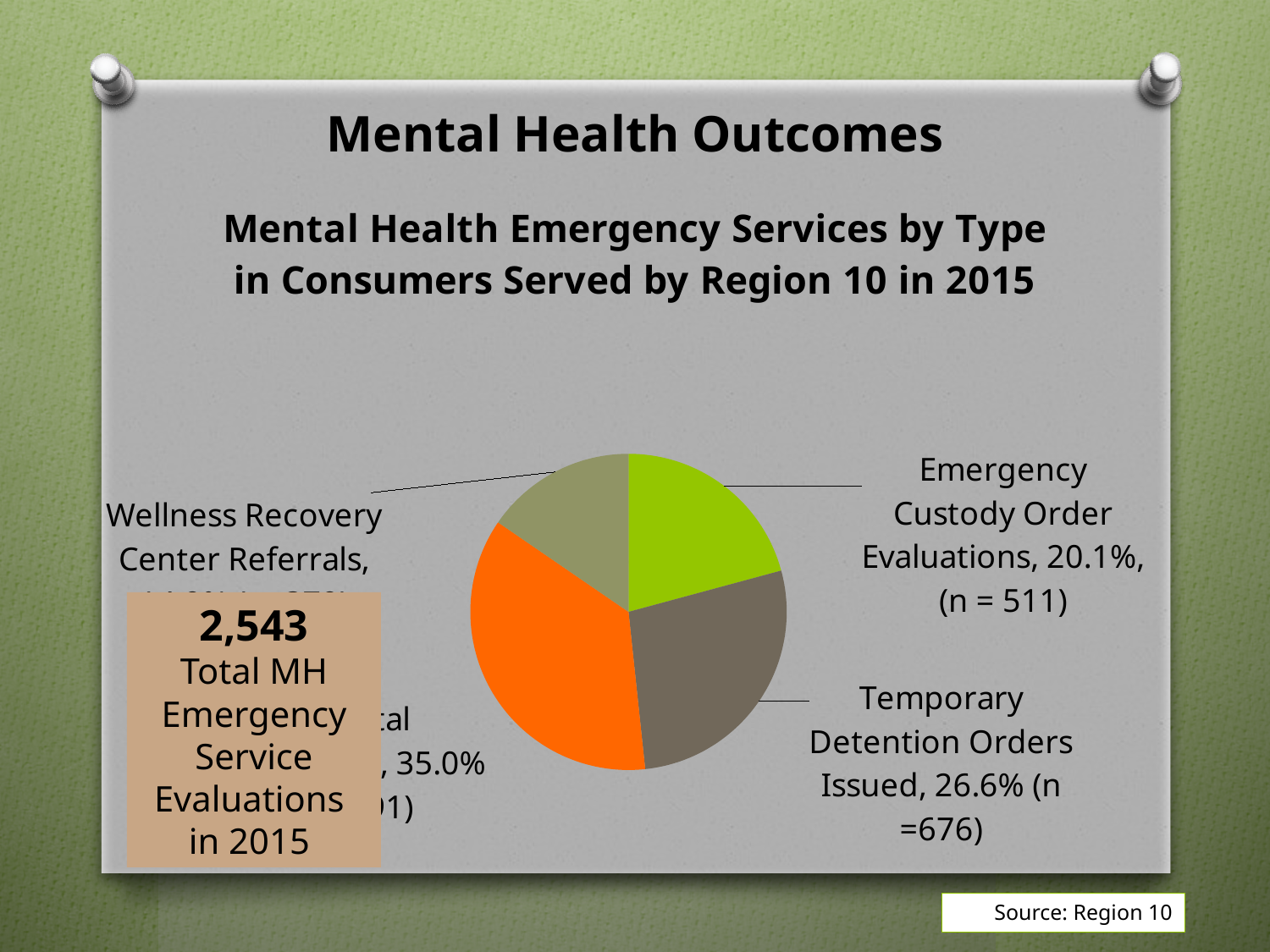
What percentage of the pie is Emergency Custody Order Evaluations? 20.1% What percentage of the pie is Temporary Detention Orders Issued? 26.6% Which is larger: Temporary Detention Orders Issued or Emergency Custody Order Evaluations? Temporary Detention Orders Issued How many more consumers had Temporary Detention Orders Issued than Emergency Custody Order Evaluations? 165 What is the n value for Emergency Custody Order Evaluations? 511 How many slices does the pie chart have? 4 What kind of chart is shown on the slide? pie chart What is the title of the chart? Mental Health Emergency Services by Type in Consumers Served by Region 10 in 2015 What is the total number of MH Emergency Service Evaluations in 2015 shown on the slide? 2,543 What is the n value for Temporary Detention Orders Issued? 676 What is the difference in percentage points between Temporary Detention Orders Issued and Emergency Custody Order Evaluations? 6.5